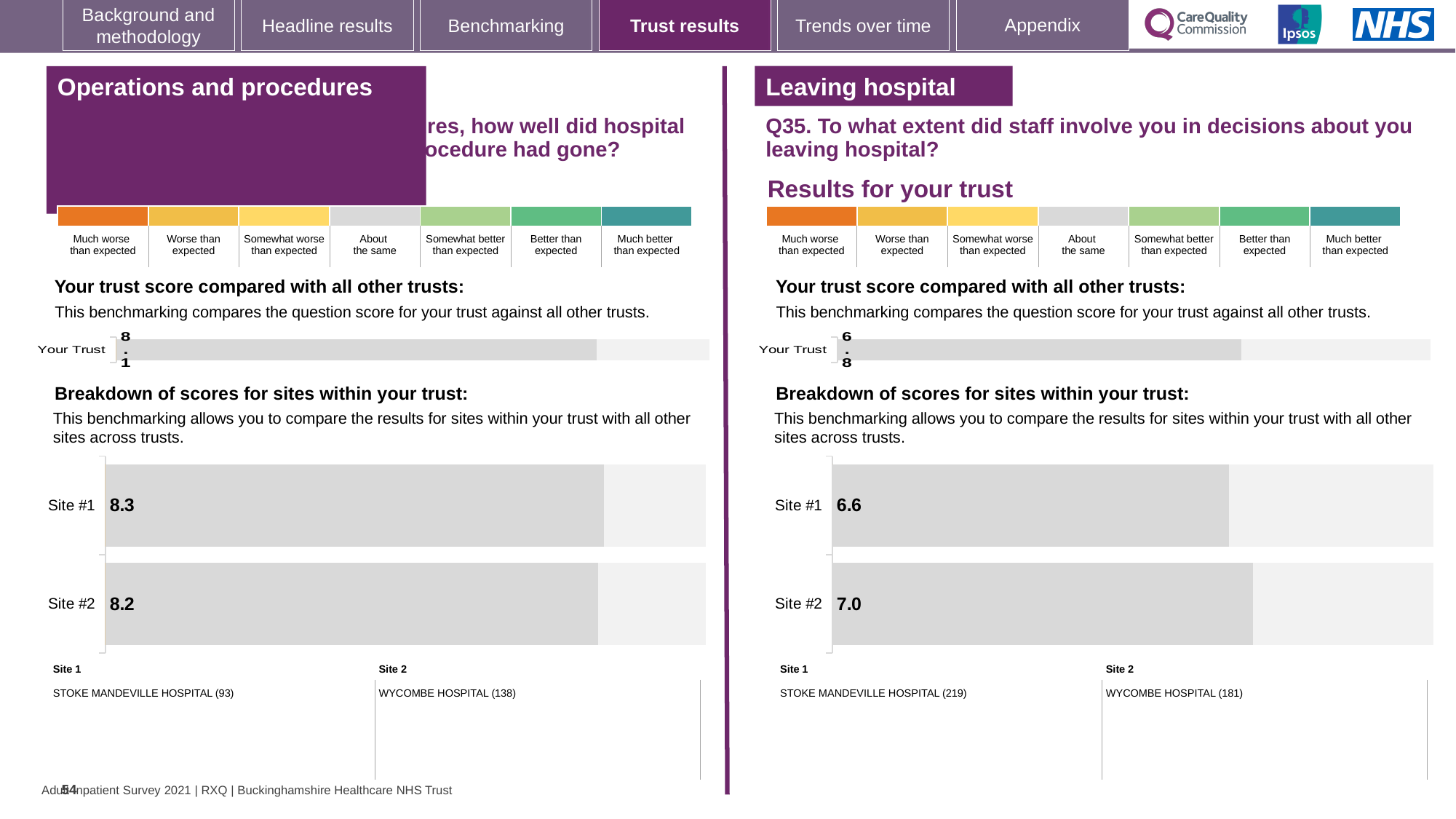
In the Operations and procedures section, what is the score for Site #1 in the breakdown of scores for sites within your trust? 8.3 In the Leaving hospital site breakdown chart, which site has the higher score? Site #2 In the Operations and procedures section, what is the score for Site #2 in the breakdown of scores for sites within your trust? 8.2 In the Leaving hospital section, what is the score for Site #2 in the breakdown of scores for sites within your trust? 7.0 In the Leaving hospital section, what is the Your Trust score in the chart comparing your trust with all other trusts? 6.8 In the Operations and procedures site breakdown chart, which site has the lower score? Site #2 In the Operations and procedures site breakdown chart, what is the difference between the Site #1 and Site #2 scores? 0.1 In the Operations and procedures section, what is the Your Trust score in the chart comparing your trust with all other trusts? 8.1 In the Leaving hospital section, what is the score for Site #1 in the breakdown of scores for sites within your trust? 6.6 How many sites are shown in the Leaving hospital site breakdown chart? 2 What type of chart is used for the breakdown of scores for sites within your trust in the Operations and procedures section? Bar chart In the Leaving hospital site breakdown chart, what is the difference between the Site #2 and Site #1 scores? 0.4